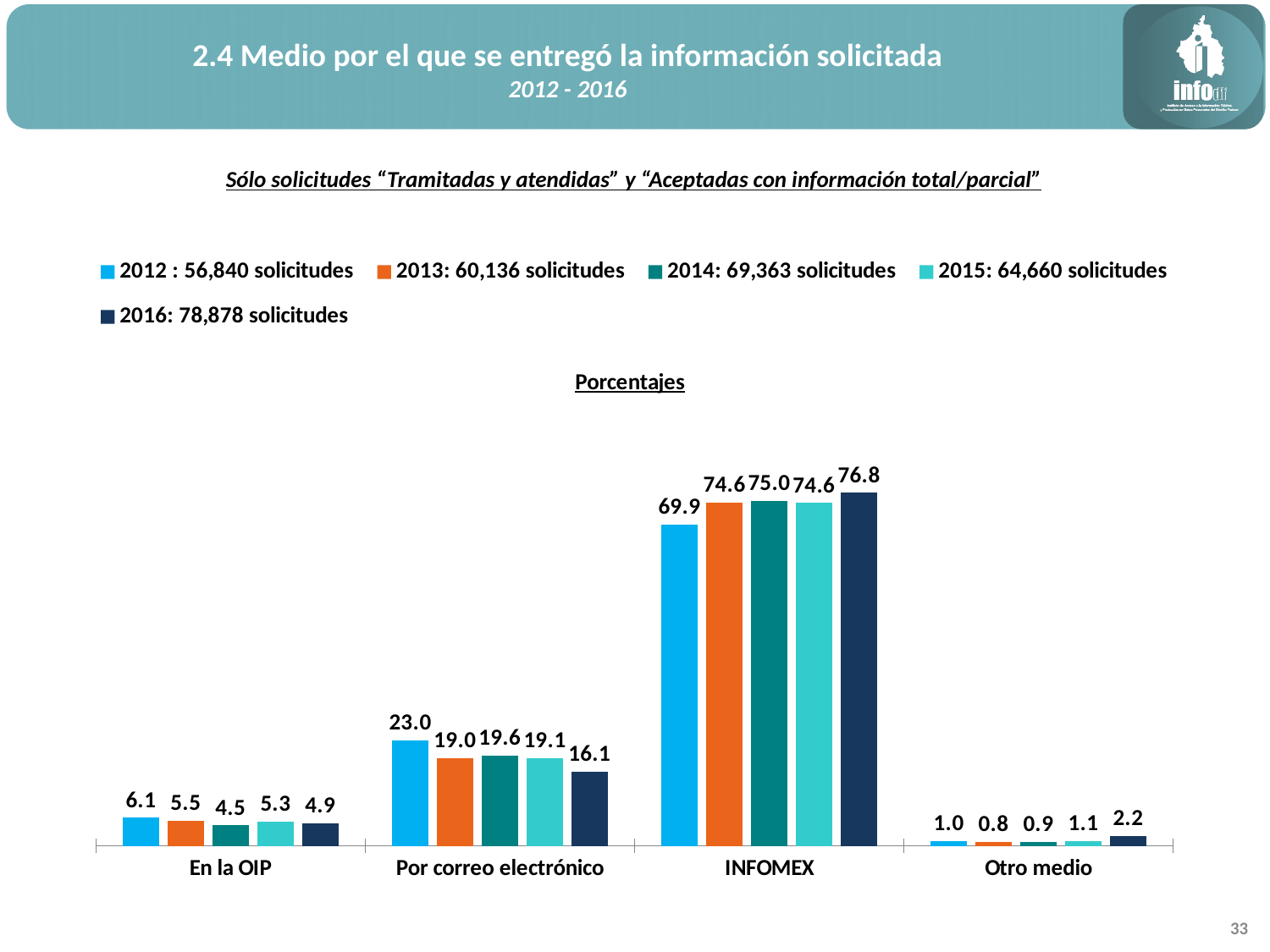
What is the value for En la OIP in 2014? 4.5 Which category has the lowest value for 2012? Otro medio What is the value for Otro medio in 2013? 0.8 What is the difference between the 2016 and 2012 values for INFOMEX? 6.9 Which category has the highest value for 2015? INFOMEX Which is larger for Por correo electrónico: the 2012 value or the 2016 value? 2012 According to the legend, how many solicitudes were there in 2014? 69,363 What kind of chart is shown on the slide? Bar chart What is the value for INFOMEX in 2016? 76.8 How many series does the legend list? 5 How many categories are shown on the x axis? 4 What is the value for Por correo electrónico in 2012? 23.0